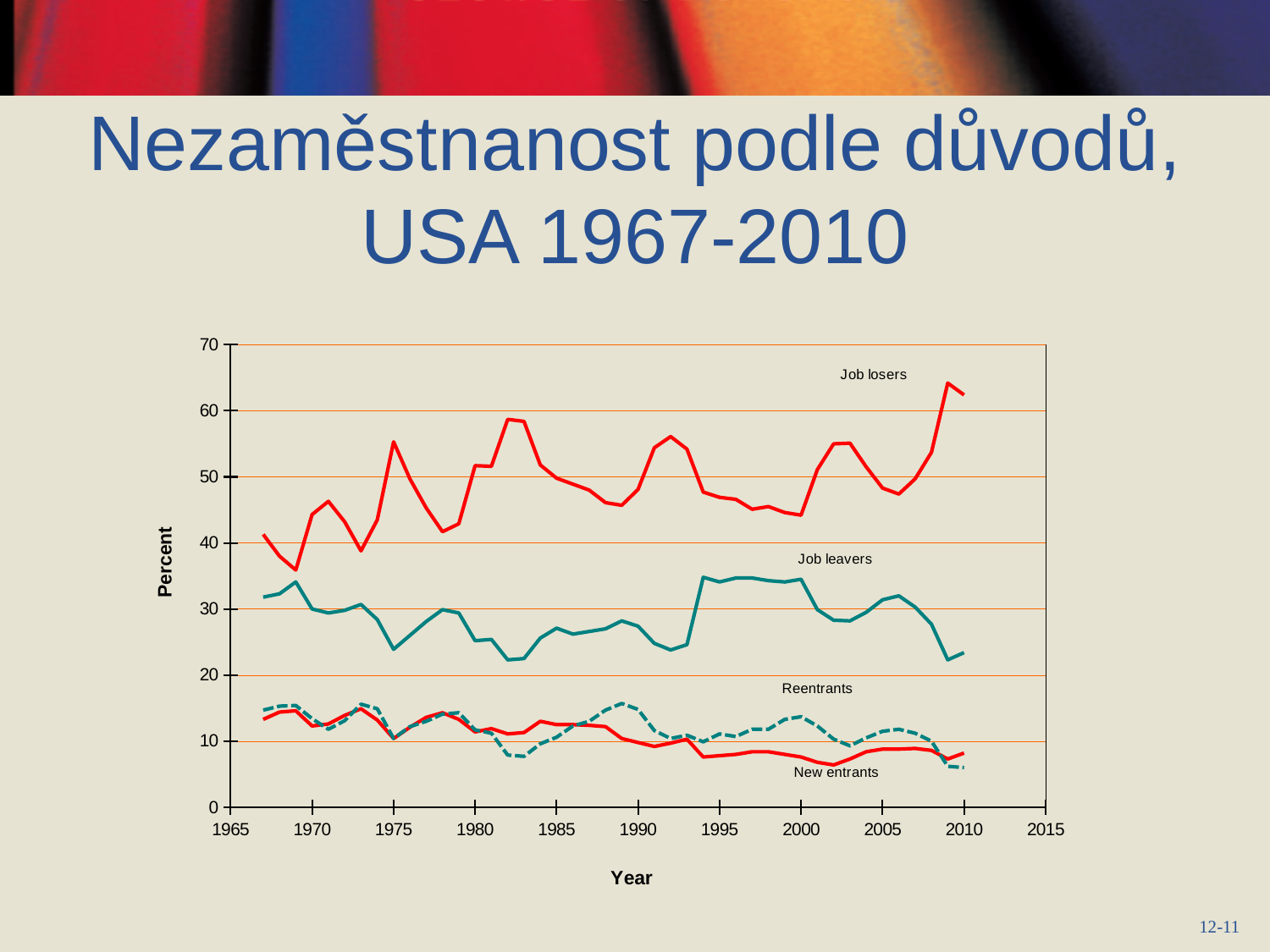
Which series has the highest values throughout the chart? Job losers Is the value for New entrants in 2010 greater or less than 10? less What kind of chart is shown on the slide? line chart How many series (labelled lines) are plotted on the chart? 4 Do the values for Job losers rise or fall between 2006 and 2010? rise Is the value for Job leavers in 2009 greater or less than 30? less What is the label of the horizontal axis? Year In 2010, which is larger: Job losers or Job leavers? Job losers Is the value for Job losers in 2010 greater or less than 60? greater What is the label of the vertical axis? Percent